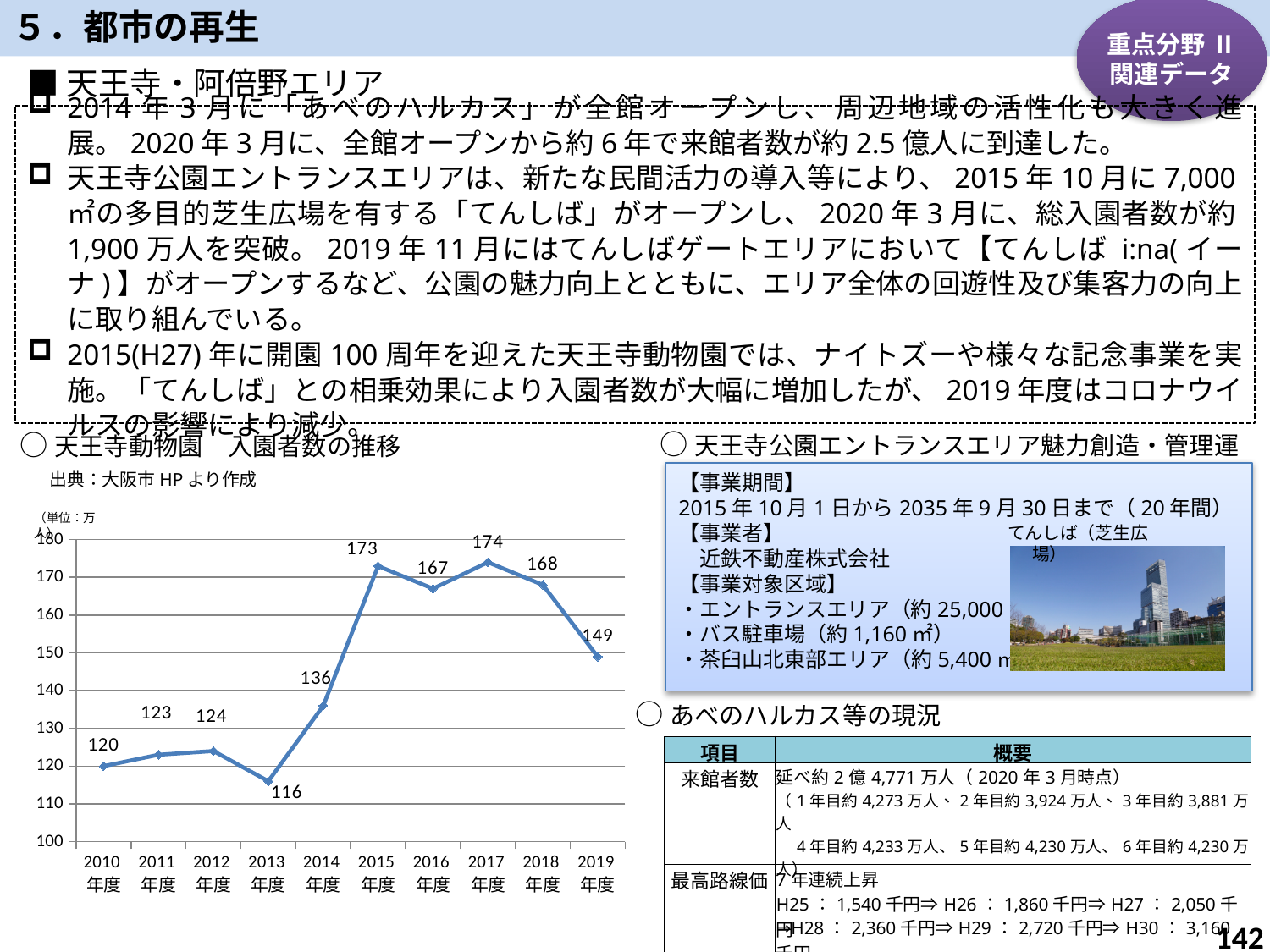
What unit is shown for the values in the 天王寺動物園 入園者数の推移 chart? 万人 What kind of chart is the 天王寺動物園 入園者数の推移 chart? line chart What is the value for 2019年度 in the 天王寺動物園 入園者数の推移 chart? 149 How many years are plotted in the 天王寺動物園 入園者数の推移 chart? 10 Which year has the lowest value in the 天王寺動物園 入園者数の推移 chart? 2013年度 What is the value for 2015年度 in the 天王寺動物園 入園者数の推移 chart? 173 In the 天王寺動物園 入園者数の推移 chart, what is the difference between the values for 2018年度 and 2019年度? 19 In the 天王寺動物園 入園者数の推移 chart, which is larger, the value for 2016年度 or 2018年度? 2018年度 What is the value for 2010年度 in the 天王寺動物園 入園者数の推移 chart? 120 In the 天王寺動物園 入園者数の推移 chart, is the value for 2014年度 greater or less than 130? greater In the 天王寺動物園 入園者数の推移 chart, what is the difference between the values for 2015年度 and 2014年度? 37 Which year has the highest value in the 天王寺動物園 入園者数の推移 chart? 2017年度